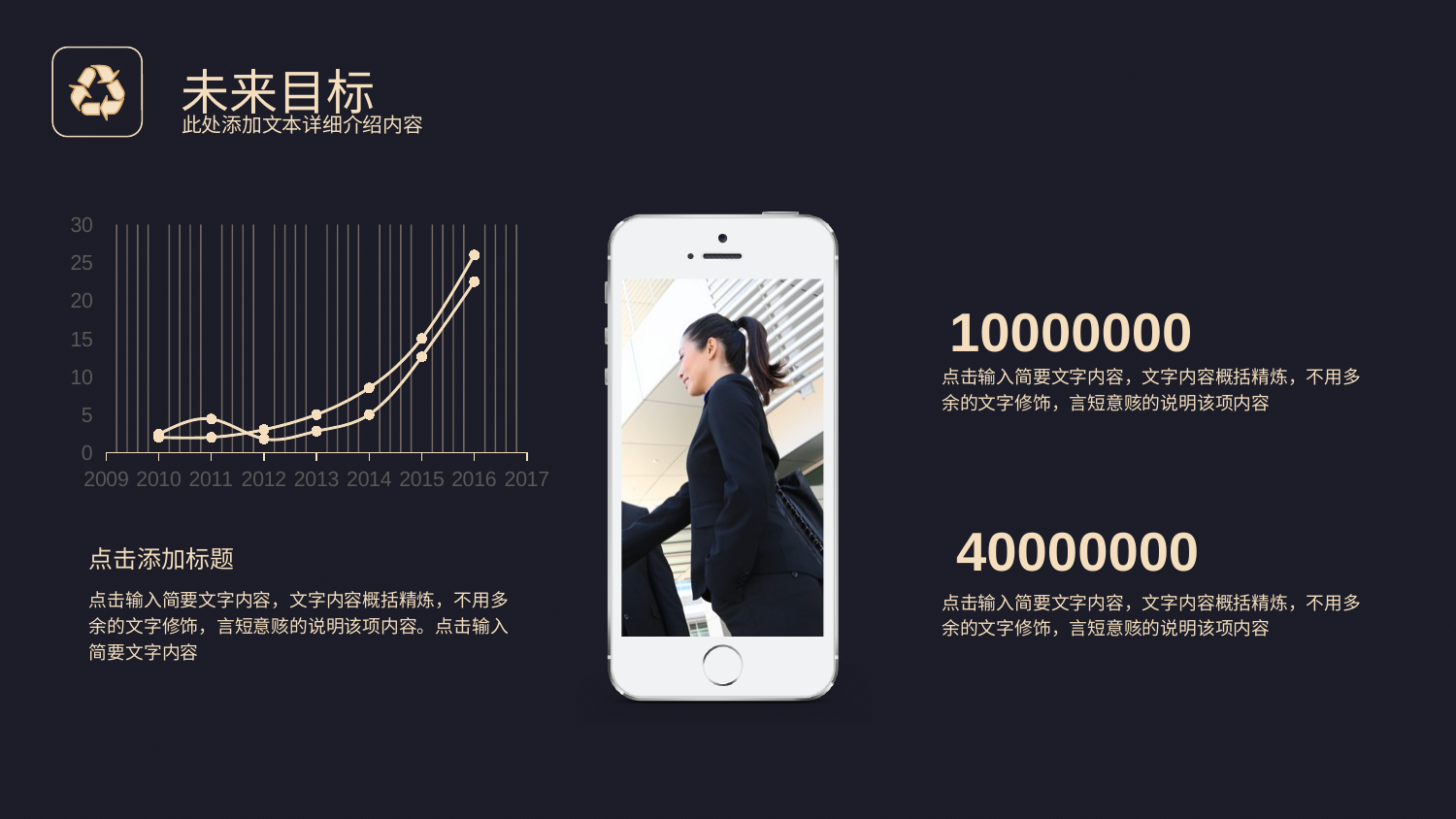
Do the values on the chart rise or fall from 2013 to 2016? rise How many data points does each line on the chart have? 7 Is the value for 2013 on the lower line greater or less than 5? less Which year has the larger value on the upper line, 2015 or 2016? 2016 Is the value for 2012 on the upper line greater or less than 5? less Which year has the highest value on the chart? 2016 What is the highest value shown on the chart's y axis? 30 What is the first year label shown on the chart's x axis? 2009 Is the value for 2016 on the upper line greater or less than 20? greater What kind of chart is shown on the slide? line chart How many lines (series) are plotted on the chart? 2